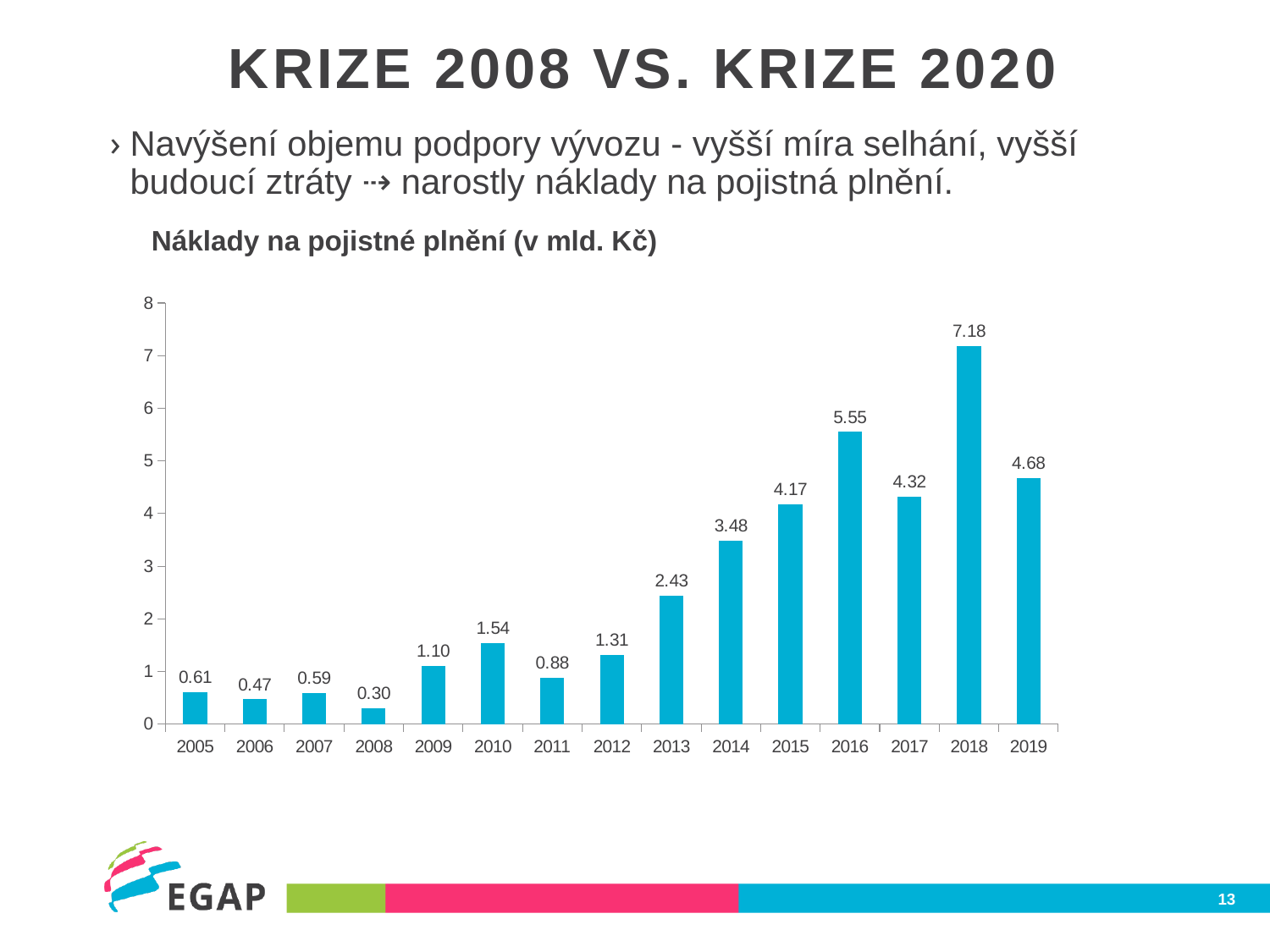
Which year has the highest value? 2018 What is the difference between the values for 2018 and 2019? 2.50 How many years are shown on the x axis? 15 What is the value for 2013? 2.43 Which is larger, the value for 2016 or the value for 2017? 2016 What is the value for 2018? 7.18 What is the value for 2008? 0.30 What kind of chart is shown? bar chart Which year has the lowest value? 2008 Do the values generally rise or fall from 2008 to 2018? rise Is the value for 2015 greater or less than 4? greater What is the title of the chart? Náklady na pojistné plnění (v mld. Kč)